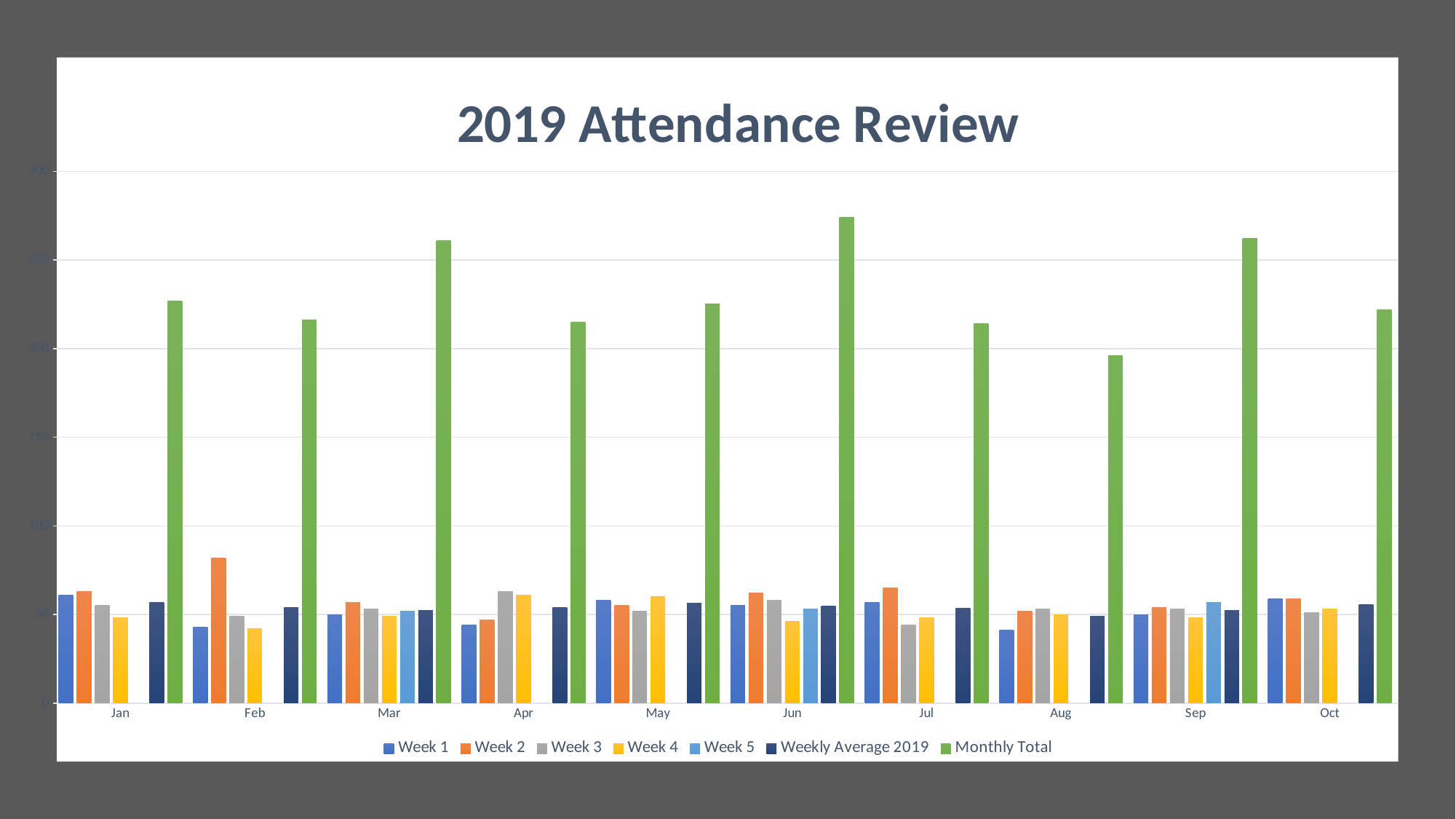
Which month has the lowest Monthly Total bar? Aug How many months are shown on the x axis? 10 What is the title of the chart? 2019 Attendance Review Is the Week 2 value for Feb greater or less than 50? greater Which is larger, the Monthly Total for Mar or the Monthly Total for Apr? Mar In Feb, which is larger, the Week 1 bar or the Week 2 bar? Week 2 What kind of chart is shown on the slide? bar chart Is the Monthly Total for Aug greater or less than 200? less Is the Monthly Total for Jun greater or less than 250? greater How many series does the legend list? 7 Which month has the highest Monthly Total bar? Jun